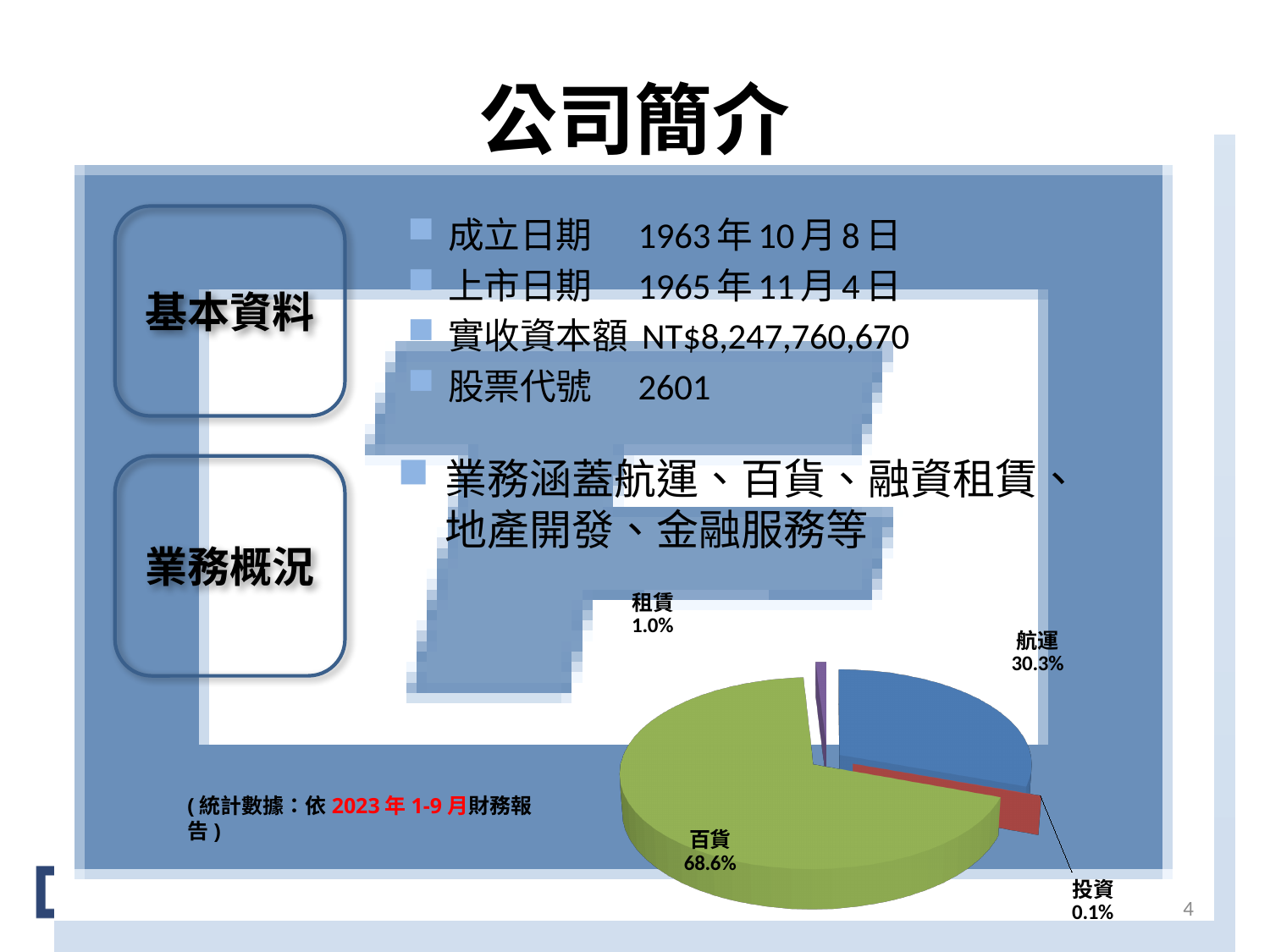
What is the difference between the 租賃 share and the 投資 share in the pie chart? 0.9% What kind of chart is shown on the slide? pie chart Which slice of the pie chart is the smallest? 投資 What is the value shown for 租賃 in the pie chart? 1.0% What share of the pie does 百貨 represent? 68.6% What colour is the 百貨 slice in the pie chart? green Which is larger in the pie chart, 航運 or 租賃? 航運 Which slice of the pie chart is the largest? 百貨 What is the difference between the 百貨 share and the 航運 share in the pie chart? 38.3% How many slices does the pie chart have? 4 What is the value shown for 投資 in the pie chart? 0.1% What share of the pie does 航運 represent? 30.3%